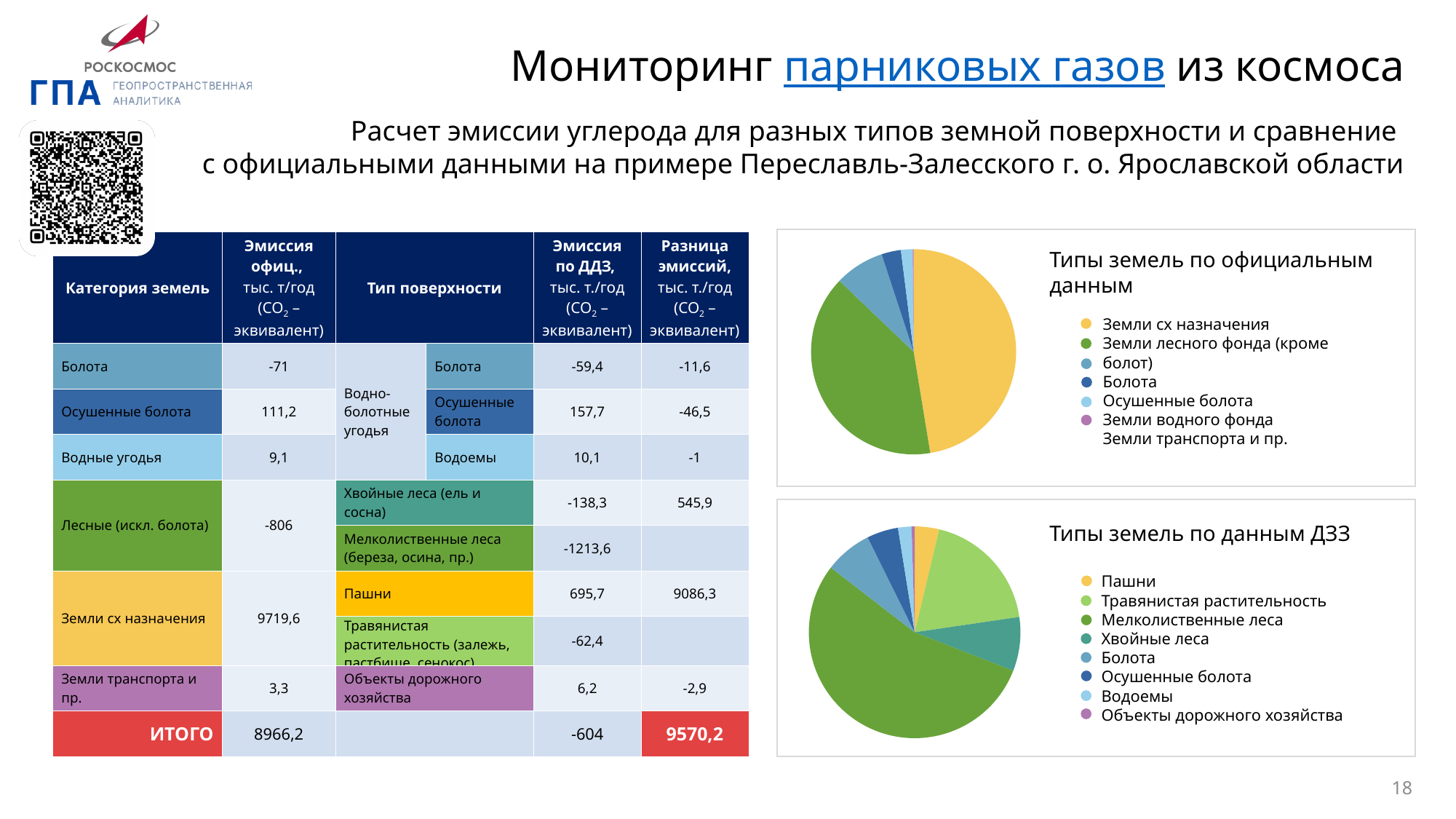
In the chart "Типы земель по данным ДЗЗ", which slice is larger: Хвойные леса or Водоемы? Хвойные леса What kind of chart is the chart titled "Типы земель по данным ДЗЗ"? pie chart In the chart "Типы земель по данным ДЗЗ", which category has the largest slice? Мелколиственные леса In the chart "Типы земель по данным ДЗЗ", how many categories does the legend list? 8 What kind of chart is the chart titled "Типы земель по официальным данным"? pie chart In the chart "Типы земель по данным ДЗЗ", which category has the smallest slice? Объекты дорожного хозяйства What is the title of the upper pie chart on the right side of the slide? Типы земель по официальным данным In the chart "Типы земель по официальным данным", which category has the largest slice? Земли сх назначения In the chart "Типы земель по официальным данным", how many categories does the legend list? 6 In the chart "Типы земель по официальным данным", which slice is larger: Земли сх назначения or Болота? Земли сх назначения In the chart "Типы земель по данным ДЗЗ", which slice is larger: Травянистая растительность or Пашни? Травянистая растительность In the chart "Типы земель по данным ДЗЗ", what colour is the slice for Пашни? yellow